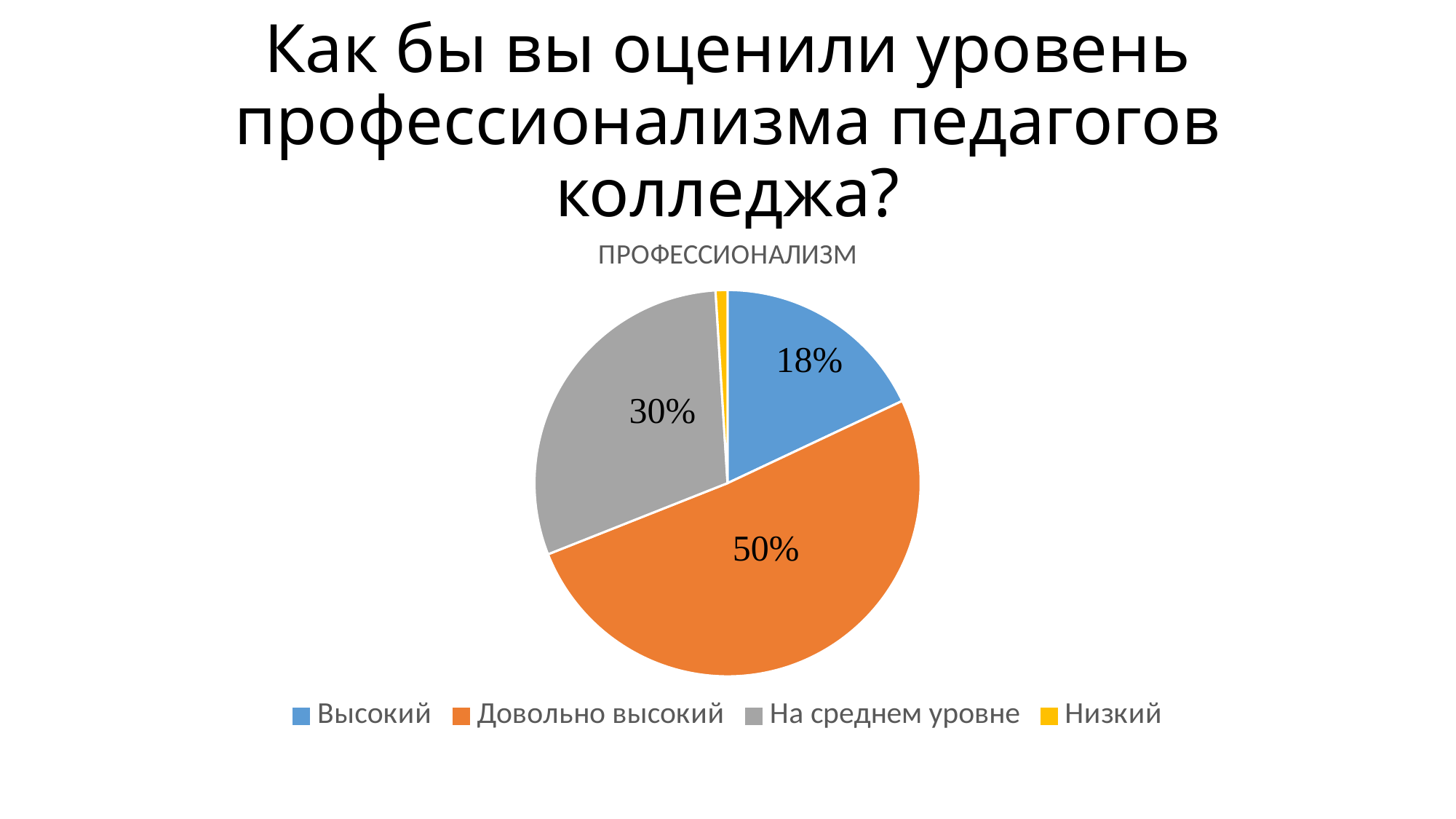
Which category has the largest share of the pie? Довольно высокий What percentage of respondents rated the level as "На среднем уровне"? 30% What is the title of the chart? ПРОФЕССИОНАЛИЗМ What colour is the slice for "Довольно высокий"? Orange What is the difference in percentage points between "На среднем уровне" and "Высокий"? 12 What is the difference in percentage points between "Довольно высокий" and "Высокий"? 32 What type of chart is shown on the slide? Pie chart Which category has the smallest share of the pie? Низкий What percentage of respondents rated the level as "Довольно высокий"? 50% What percentage of respondents rated the level as "Высокий"? 18% How many categories does the legend list? 4 Which is larger: the share for "На среднем уровне" or the share for "Высокий"? На среднем уровне